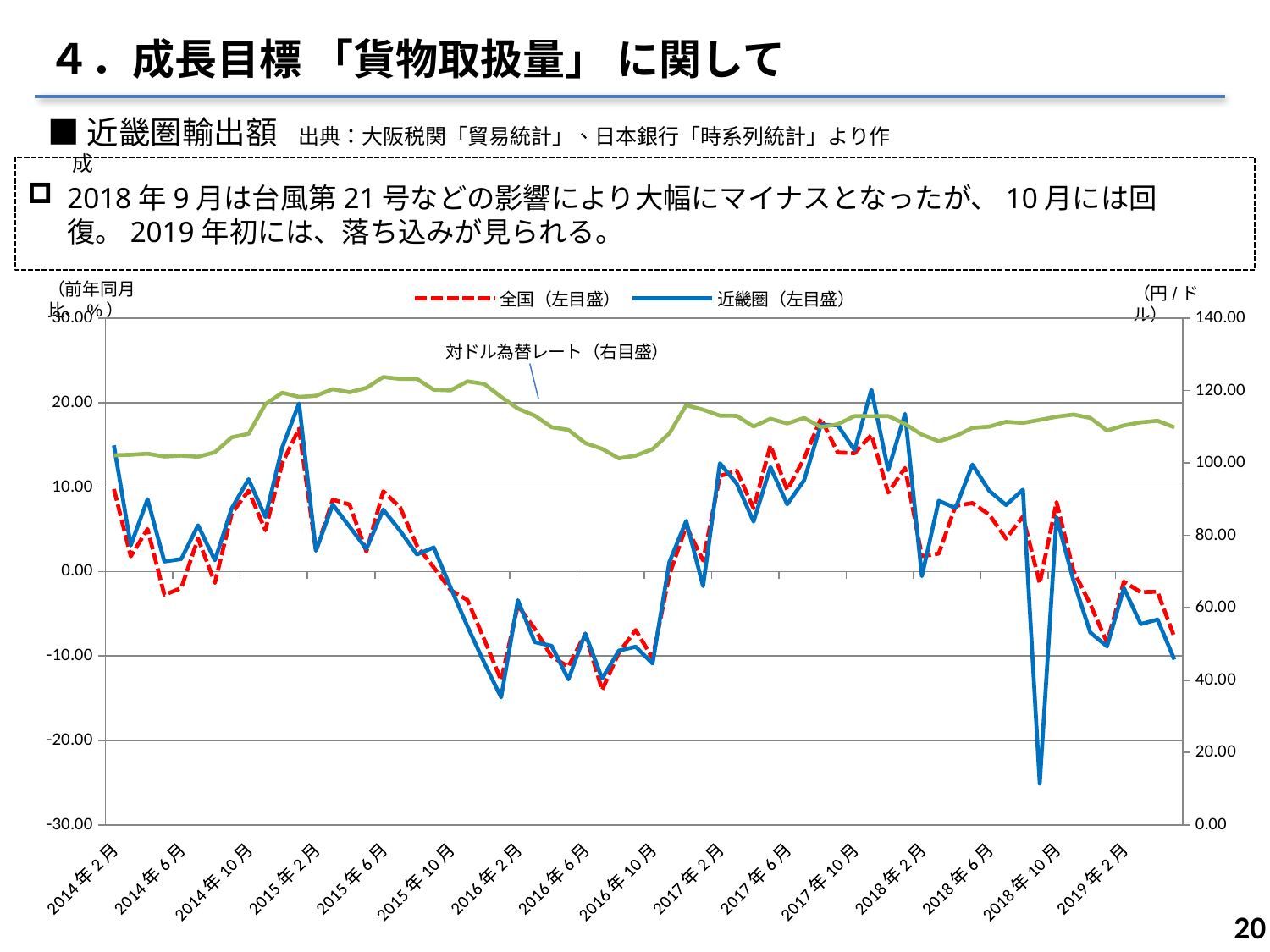
What kind of chart is shown on the slide? line chart Is the 対ドル為替レート at 2014年2月 greater or less than 80.00 on the right axis? greater Which series is drawn as a dashed red line? 全国（左目盛） What unit is shown for the right-hand axis? 円/ドル In which year does the 近畿圏 series reach its lowest value? 2018年 Is the value of 近畿圏 at its sharp dip just before 2018年10月 greater or less than -20.00? less How many series does the chart's legend list? 2 Is the value of 近畿圏 at 2016年2月 greater or less than -10.00? greater Does the 近畿圏 series rise or fall between 2015年2月 and 2016年2月? fall At the sharp dip just before 2018年10月, which series is lower, 全国 or 近畿圏? 近畿圏